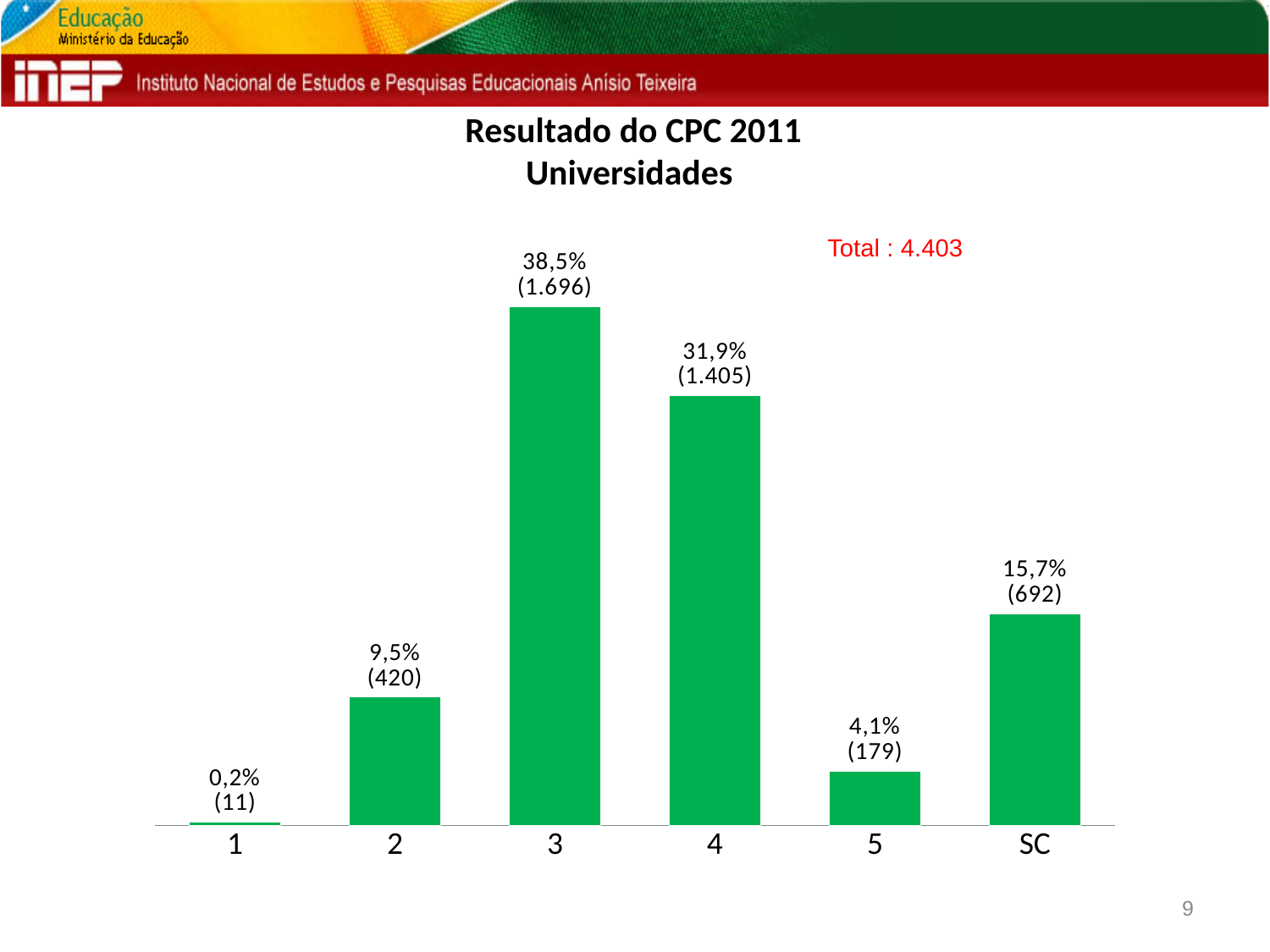
What is the difference in percentage points between category 3 and category 4? 6,6 What kind of chart is shown on the slide? bar chart How many categories are shown on the x axis? 6 What total is stated in red text on the slide? 4.403 Which category has the highest value? 3 What percentage is shown for the SC category? 15,7% Which has a larger value, category 2 or category 5? 2 What is the difference between the counts for category 5 and category 1? 168 Which category has the lowest value? 1 What percentage is shown for category 3? 38,5% What count is shown in parentheses for category 2? 420 What count is shown in parentheses for category 4? 1.405